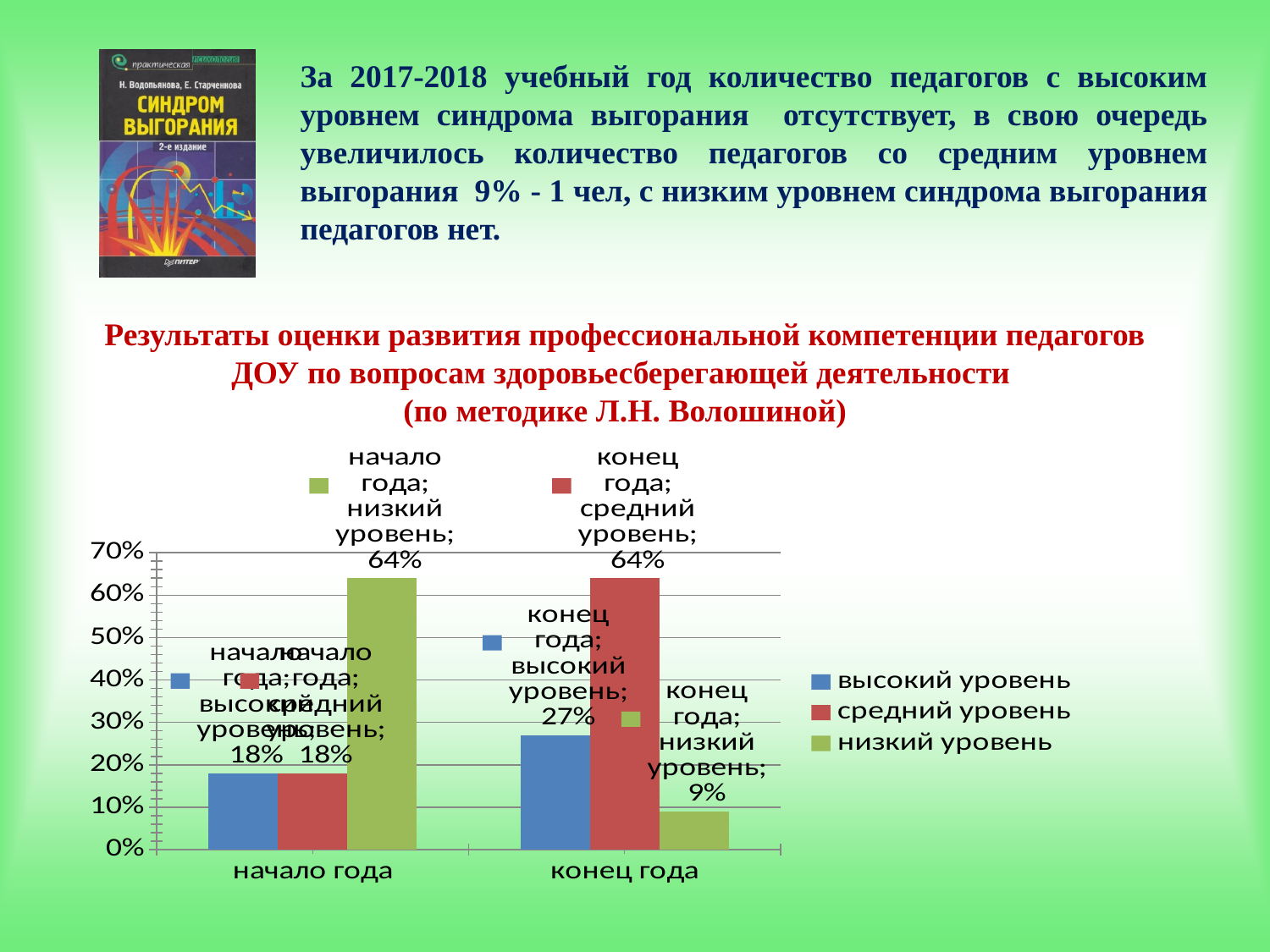
Which is larger: "высокий уровень" at "начало года" or "высокий уровень" at "конец года"? конец года What is the value for "высокий уровень" at "конец года"? 27% How many categories are shown on the x axis? 2 Which series has the highest value at "конец года"? средний уровень What is the difference between "низкий уровень" at "начало года" and "низкий уровень" at "конец года"? 55% Which series has the lowest value at "конец года"? низкий уровень What kind of chart is shown on the slide? bar chart What is the value for "низкий уровень" at "конец года"? 9% Does the value for "средний уровень" rise or fall from "начало года" to "конец года"? rise What is the value for "средний уровень" at "конец года"? 64% What is the value for "низкий уровень" at "начало года"? 64% How many series does the legend list? 3